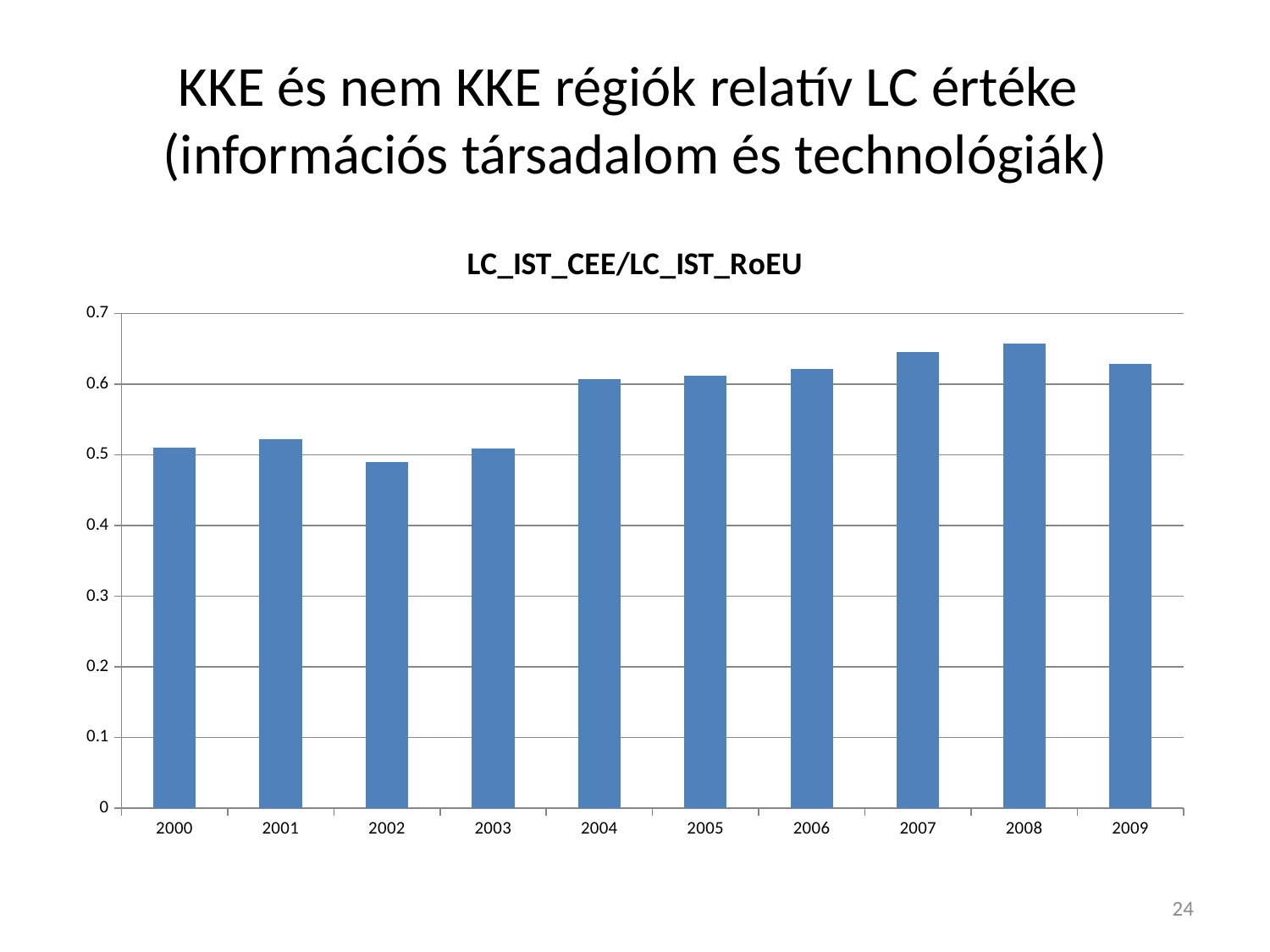
Which year has the larger value, 2008 or 2009? 2008 Which year has the larger value, 2003 or 2004? 2004 Do the values generally rise or fall from 2000 to 2009? rise Is the value for 2002 greater or less than 0.5? less Is the value for 2008 greater or less than 0.7? less Which year has the lowest value in the chart? 2002 Is the value for 2004 greater or less than 0.6? greater What kind of chart is shown on the slide? bar chart Which year has the highest value in the chart? 2008 What is the title of the chart? LC_IST_CEE/LC_IST_RoEU How many years are shown on the x axis of the chart? 10